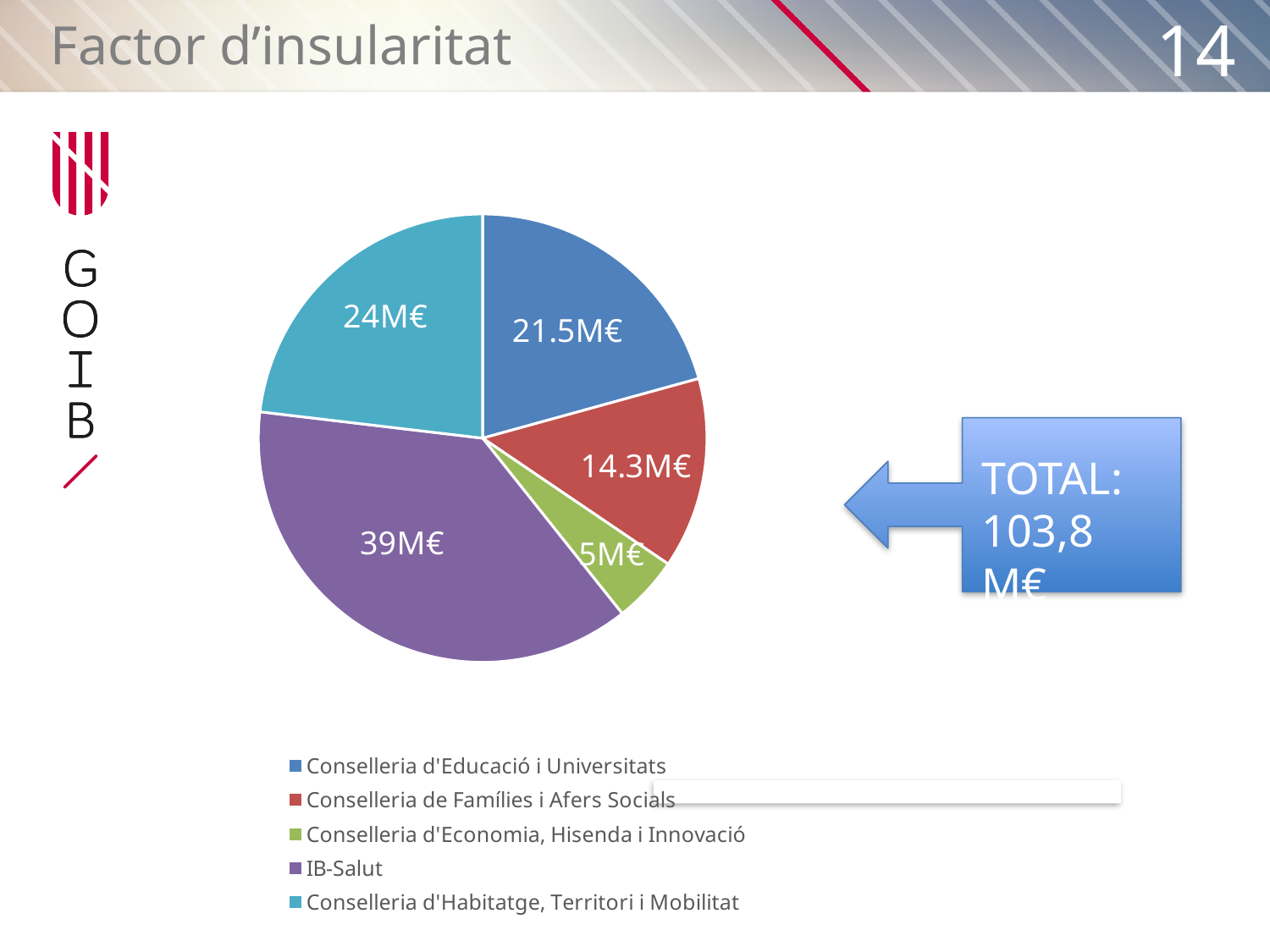
What value is shown for Conselleria de Famílies i Afers Socials? 14.3M€ What value is shown for Conselleria d'Economia, Hisenda i Innovació? 5M€ Which category has the largest slice of the pie chart? IB-Salut What kind of chart is shown on the slide? Pie chart What value is shown for Conselleria d'Educació i Universitats? 21.5M€ What total is stated in the box next to the pie chart? 103,8 M€ What value is shown for IB-Salut in the pie chart? 39M€ How many categories does the pie chart show? 5 What is the difference between the values for IB-Salut and Conselleria d'Habitatge, Territori i Mobilitat? 15M€ Which is larger, the value for Conselleria d'Educació i Universitats or for Conselleria de Famílies i Afers Socials? Conselleria d'Educació i Universitats What value is shown for Conselleria d'Habitatge, Territori i Mobilitat? 24M€ Which category has the smallest slice of the pie chart? Conselleria d'Economia, Hisenda i Innovació